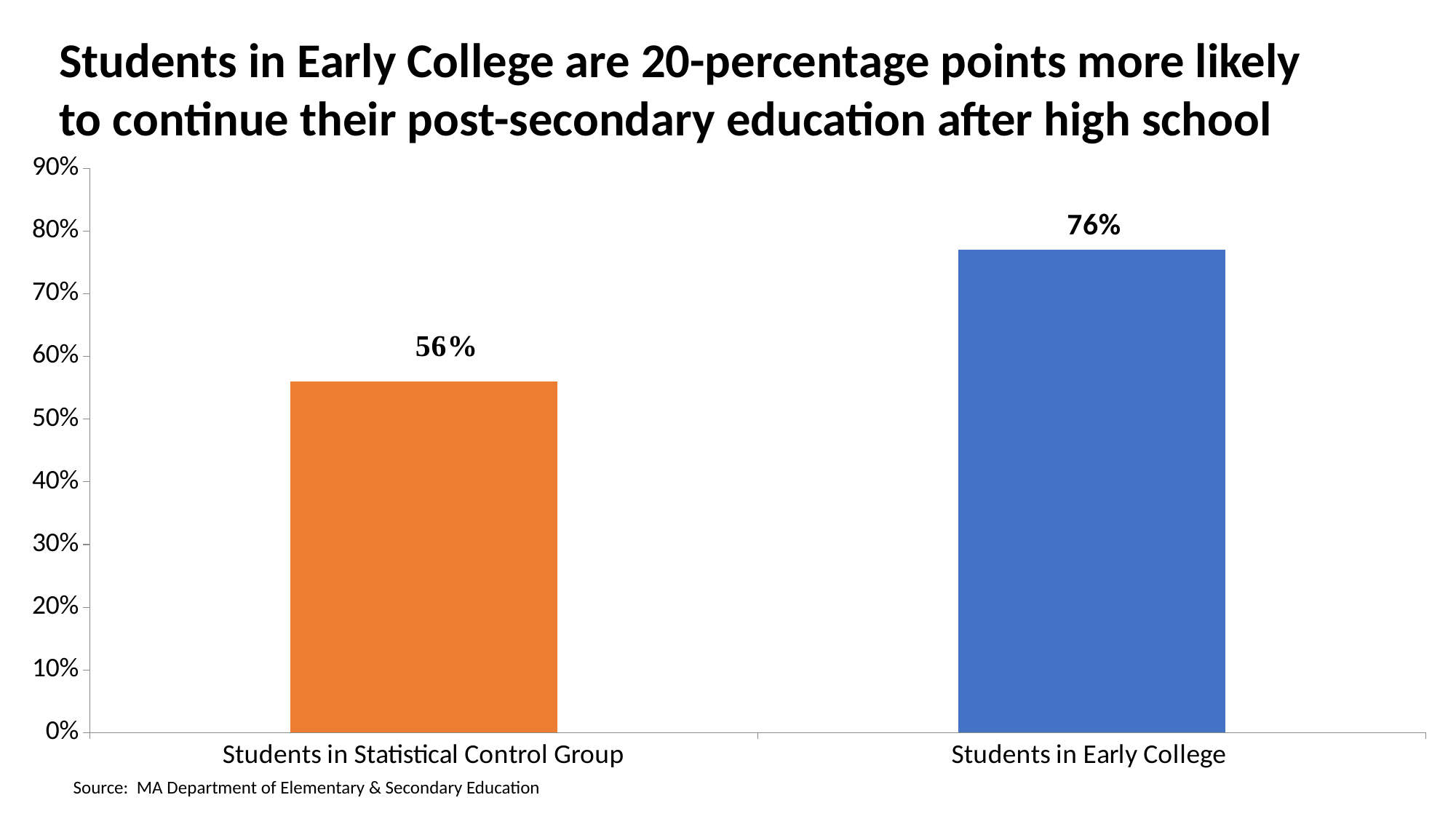
How many categories are shown on the chart? 2 Which category has the lowest value? Students in Statistical Control Group What is the difference between the values for Students in Early College and Students in Statistical Control Group? 20 percentage points Which category has the highest value? Students in Early College What is the value for Students in Early College? 76% What colour is the bar for Students in Early College? Blue Is the value for Students in Early College greater or less than 70%? greater What is the title of the chart? Students in Early College are 20-percentage points more likely to continue their post-secondary education after high school What kind of chart is shown on the slide? Bar chart Is the value for Students in Statistical Control Group greater or less than 60%? less Which is larger, the value for Students in Early College or the value for Students in Statistical Control Group? Students in Early College What is the value for Students in Statistical Control Group? 56%